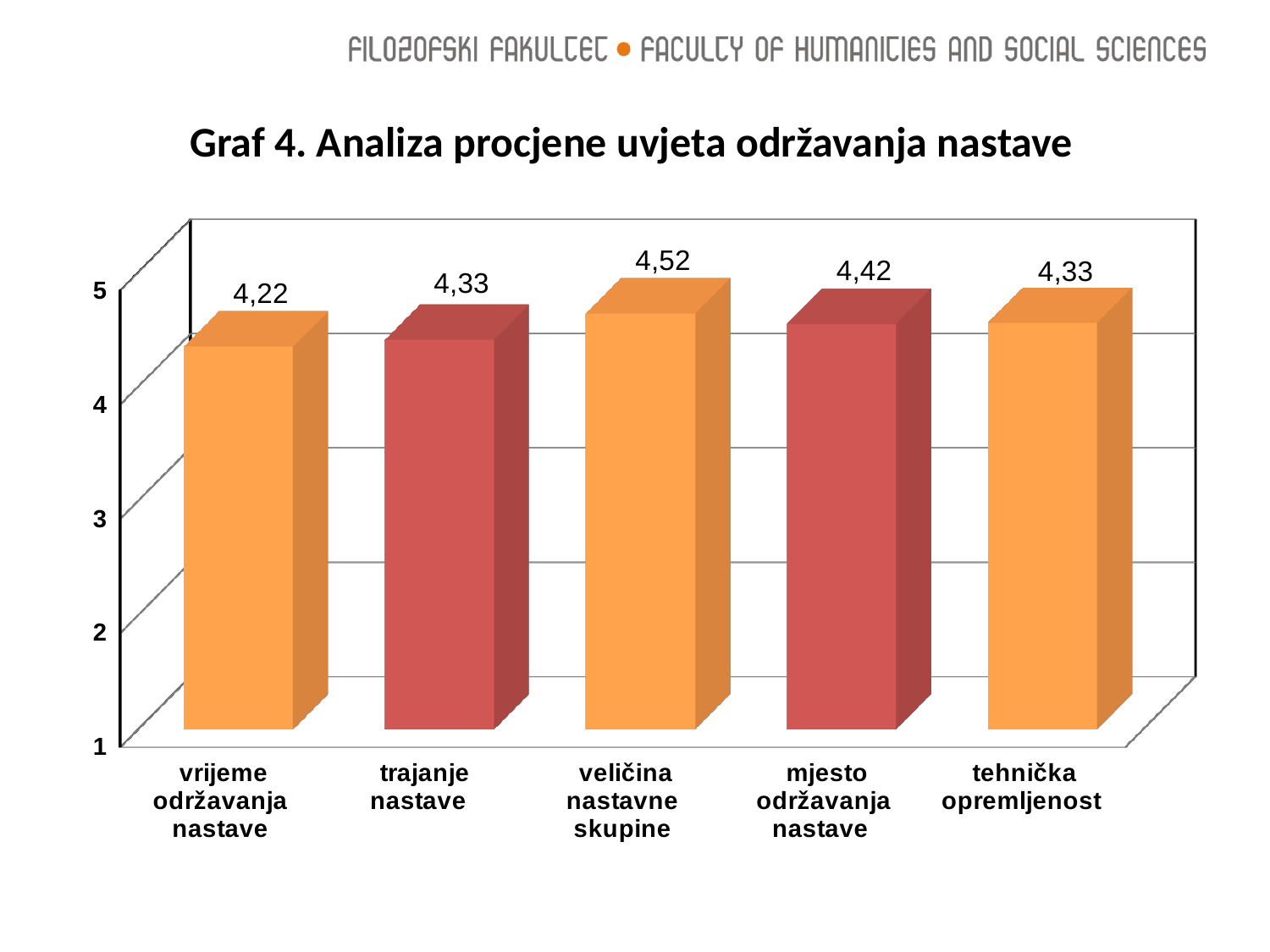
Which category has the highest value? veličina nastavne skupine Which is larger, the value for "mjesto održavanja nastave" or the value for "trajanje nastave"? mjesto održavanja nastave What is the title of the chart? Graf 4. Analiza procjene uvjeta održavanja nastave How many categories are shown on the chart? 5 Which category has the lowest value? vrijeme održavanja nastave What is the value for "mjesto održavanja nastave"? 4,42 What is the value for "veličina nastavne skupine"? 4,52 Is the value for "trajanje nastave" greater or less than 4? greater What is the value for "vrijeme održavanja nastave"? 4,22 What is the value for "tehnička opremljenost"? 4,33 What kind of chart is shown on the slide? bar chart What is the difference between the values for "veličina nastavne skupine" and "vrijeme održavanja nastave"? 0,30